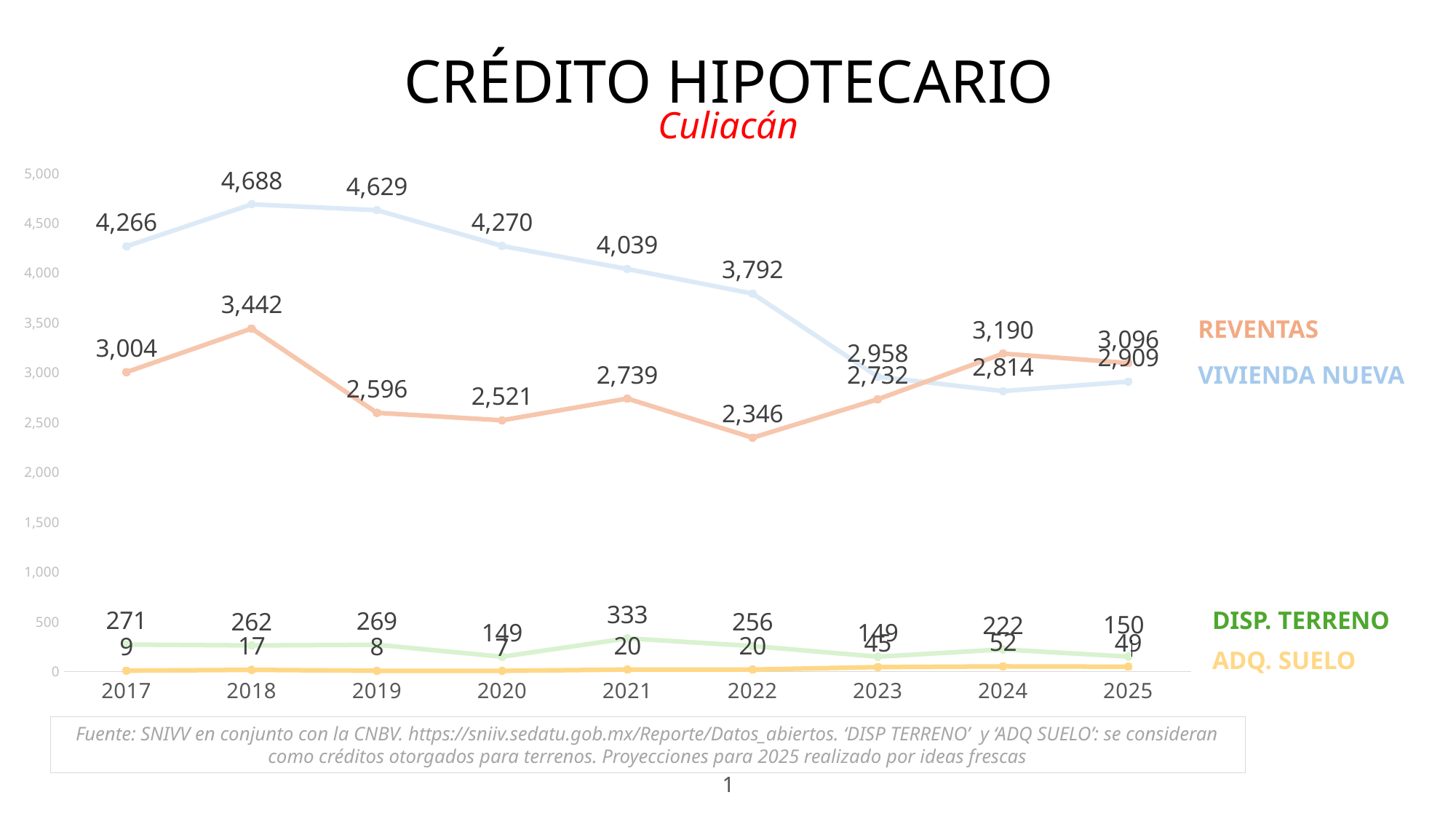
Does VIVIENDA NUEVA rise or fall from 2018 to 2024? fall What is the value for DISP. TERRENO in 2021? 333 In which year is REVENTAS lowest? 2022 What is the value for ADQ. SUELO in 2024? 52 In which year is VIVIENDA NUEVA highest? 2018 What is the value for VIVIENDA NUEVA in 2018? 4,688 Which is larger in 2024, REVENTAS or VIVIENDA NUEVA? REVENTAS What type of chart is shown on the slide? line chart What is the difference between VIVIENDA NUEVA in 2017 and in 2022? 474 How many series does the legend list? 4 What is the value for REVENTAS in 2022? 2,346 How many years are plotted on the x axis? 9